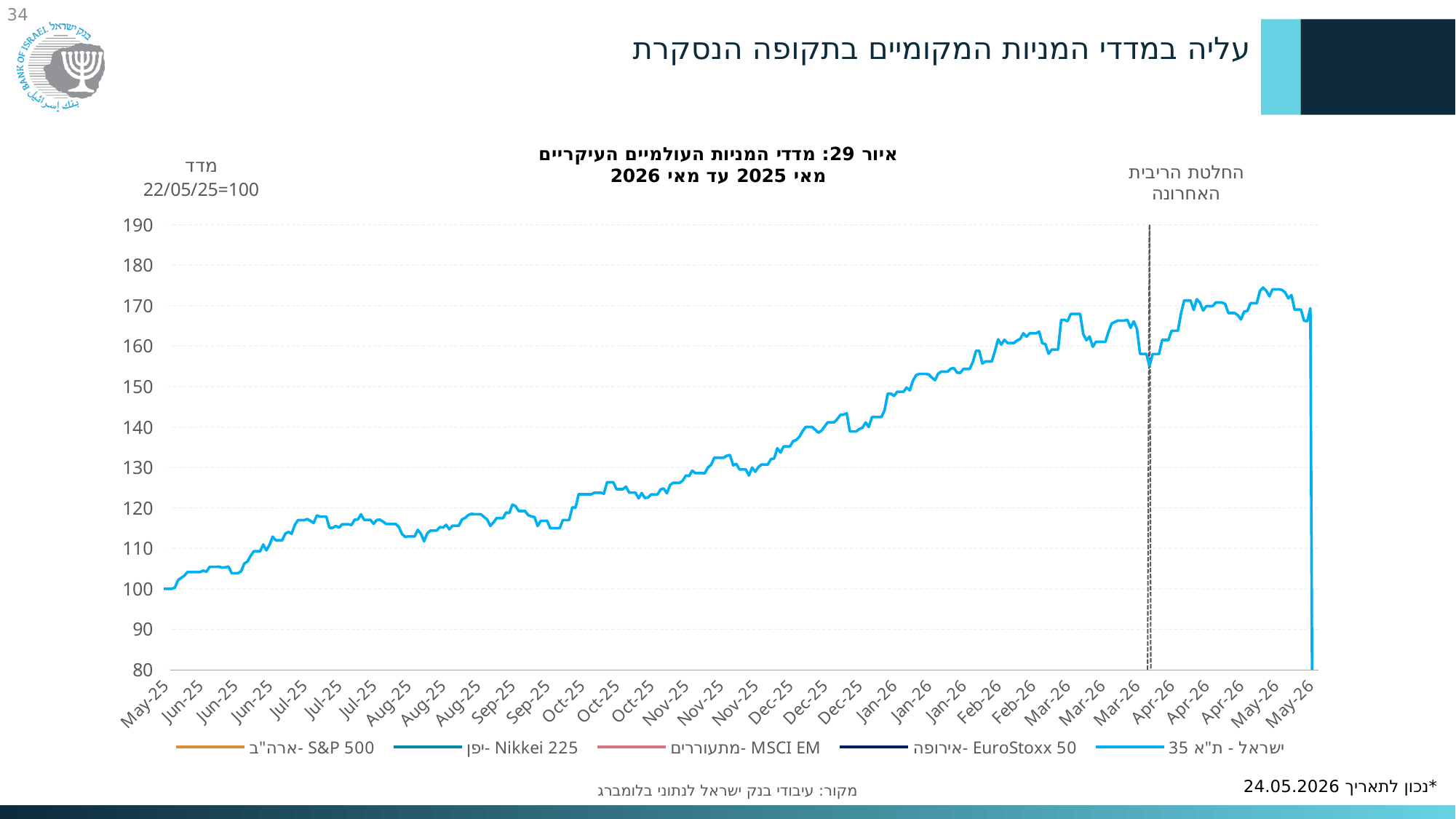
How many series does the chart's legend list? 5 Is the value of the ת"א 35 line in Mar-26 greater or less than 150? greater What kind of chart is shown on the slide? line chart Is the value of the ת"א 35 line in Aug-25 greater or less than 100? greater What does the vertical dashed line on the chart mark, according to its label? החלטת הריבית האחרונה What is the index value of the ת"א 35 line at the start of the series in May-25? 100 Is the value of the ת"א 35 line in Jul-25 greater or less than 120? less Does the plotted line for ישראל - ת"א 35 generally rise or fall from May-25 to May-26? rise What base date and value is the index set to, according to the y-axis label? 22/05/25=100 Which is larger for the ת"א 35 line: the value in Jun-25 or the value in Feb-26? Feb-26